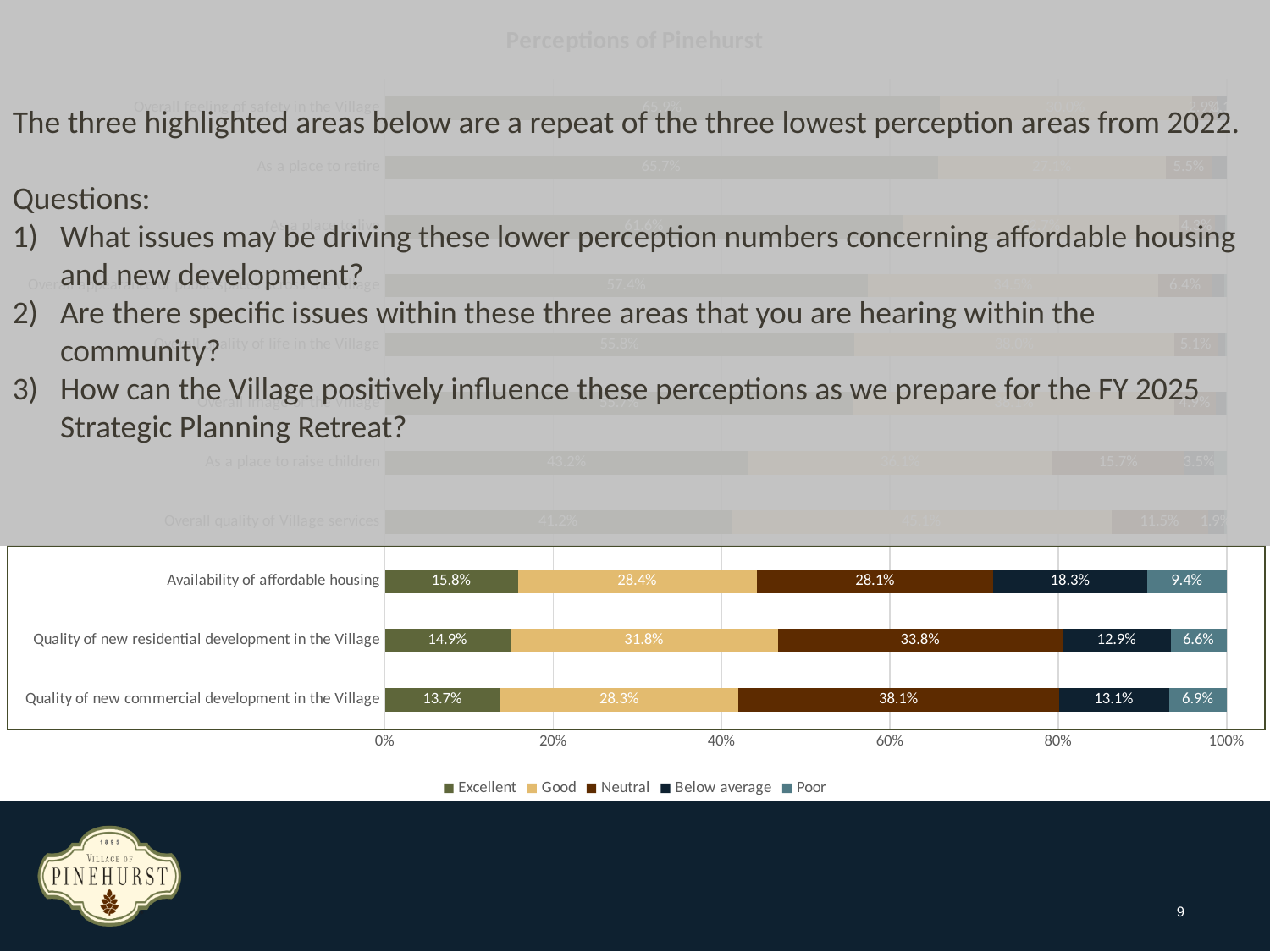
What kind of chart is shown on the slide? Stacked bar chart What is the Below average value for Availability of affordable housing? 18.3% How much higher is the Good value for Quality of new residential development in the Village than for Quality of new commercial development in the Village? 3.5 percentage points Among the three highlighted categories, which has the highest Neutral value? Quality of new commercial development in the Village Which has a larger Poor value: Availability of affordable housing or Quality of new commercial development in the Village? Availability of affordable housing What is the Poor value for Quality of new residential development in the Village? 6.6% What percentage of respondents rated Availability of affordable housing as Excellent? 15.8% What are the legend entries of the chart? Excellent, Good, Neutral, Below average, Poor What is the Neutral value for Quality of new commercial development in the Village? 38.1% How many categories are highlighted at the bottom of the chart? 3 Among the three highlighted categories, which has the lowest Excellent value? Quality of new commercial development in the Village How many series does the legend list? 5